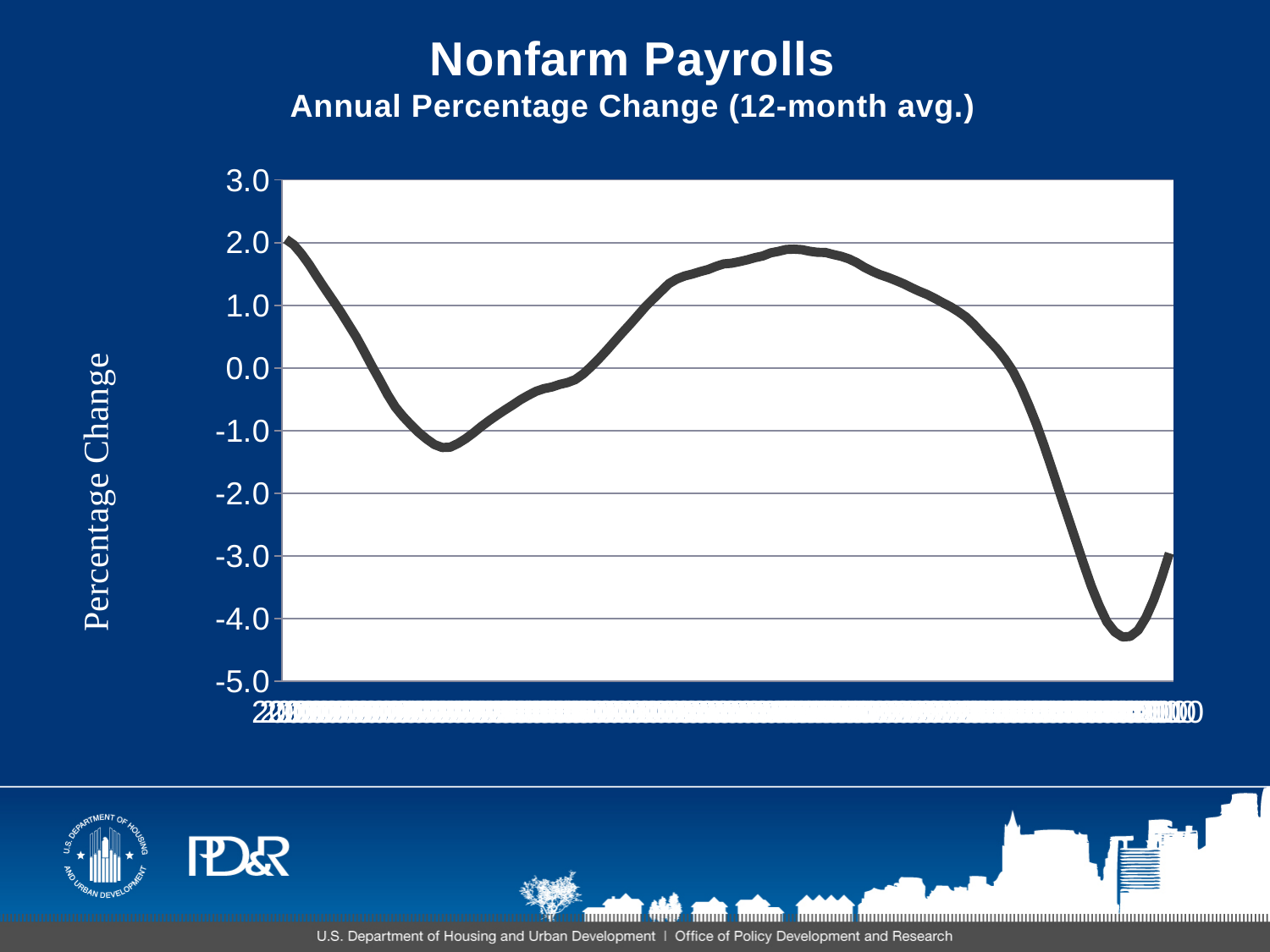
Is the highest point on the line greater or less than 1.0? greater Which is larger, the value at the start of the line or the value at the end of the line? the start of the line What kind of chart is shown on the slide? line chart Is the value at the end (right end) of the line greater or less than -2.0? less What is the title of the chart? Nonfarm Payrolls Annual Percentage Change (12-month avg.) Is the lowest point on the line greater or less than -4.0? less What is the label on the vertical axis of the chart? Percentage Change Comparing the start of the line to its end, does the value rise or fall overall? fall